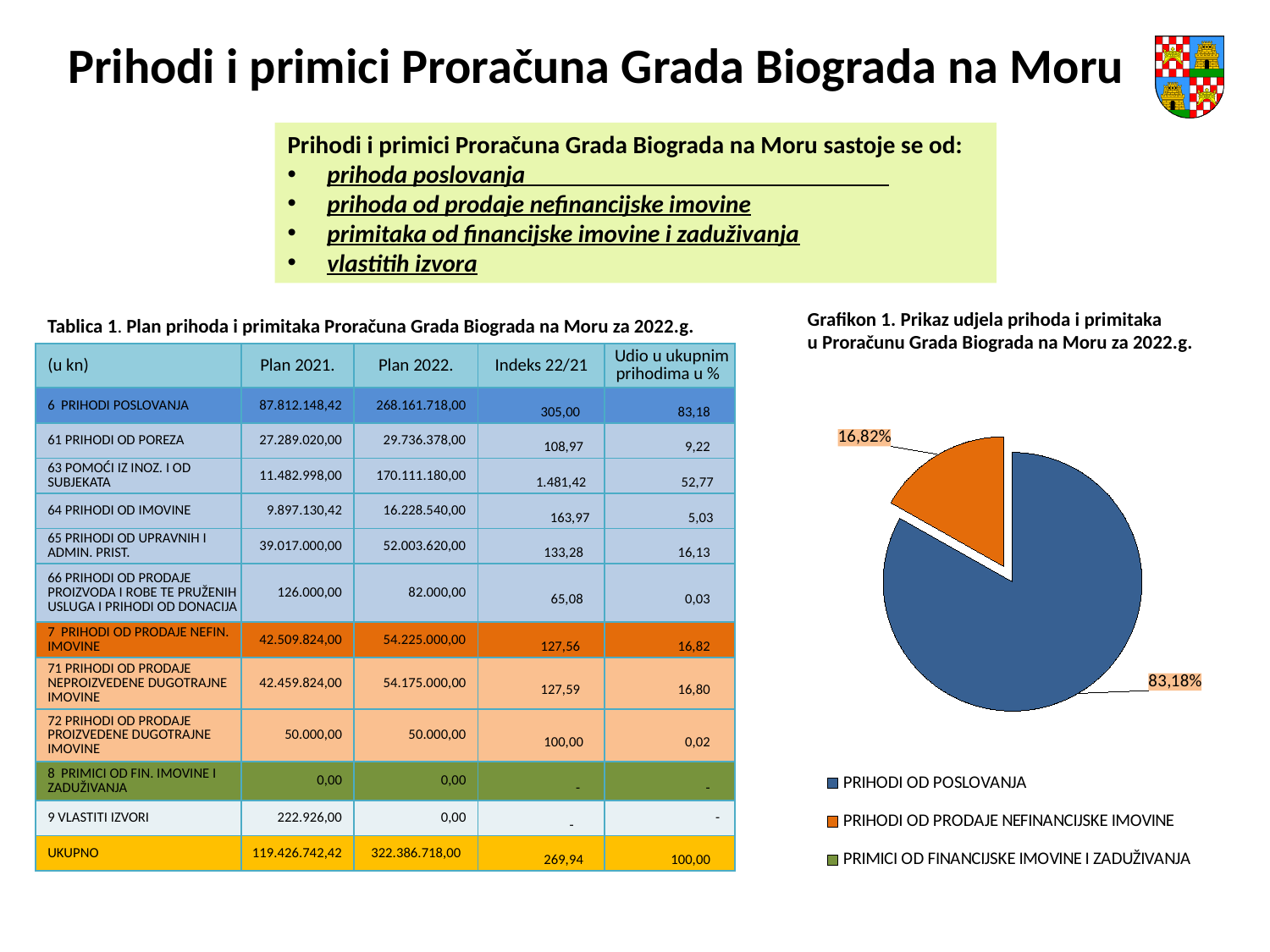
In the pie chart, what share is shown for PRIHODI OD POSLOVANJA? 83,18% What is the difference in percentage points between the two labelled slices of the pie chart? 66,36 Which legend entry of the pie chart is shown in orange? PRIHODI OD PRODAJE NEFINANCIJSKE IMOVINE What kind of chart is Grafikon 1 on the slide? pie chart In the pie chart, what share is shown for PRIHODI OD PRODAJE NEFINANCIJSKE IMOVINE? 16,82% Which of the two labelled slices in the pie chart is smaller? PRIHODI OD PRODAJE NEFINANCIJSKE IMOVINE What is the title of the pie chart on the slide? Grafikon 1. Prikaz udjela prihoda i primitaka u Proračunu Grada Biograda na Moru za 2022.g. How many slices are visibly drawn in the pie chart? 2 How many entries does the legend of the pie chart list? 3 Which category has the largest slice in the pie chart? PRIHODI OD POSLOVANJA In the pie chart, which is larger: the slice for PRIHODI OD POSLOVANJA or the slice for PRIHODI OD PRODAJE NEFINANCIJSKE IMOVINE? PRIHODI OD POSLOVANJA